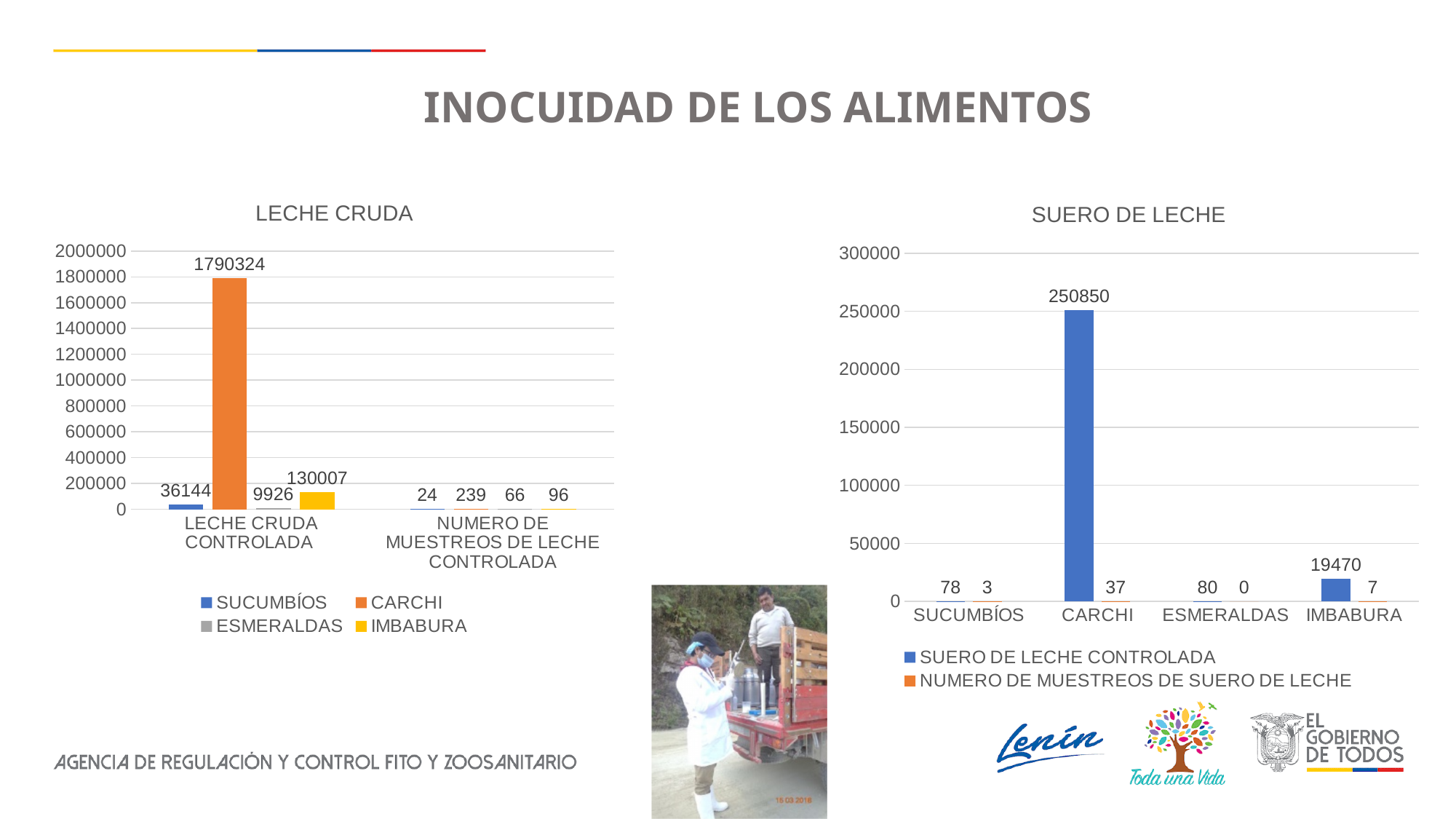
In the SUERO DE LECHE chart, what is the value of NUMERO DE MUESTREOS DE SUERO DE LECHE for ESMERALDAS? 0 In the LECHE CRUDA chart, is the value for CARCHI under LECHE CRUDA CONTROLADA greater or less than 1600000? greater In the SUERO DE LECHE chart, how many provinces are shown on the x axis? 4 In the LECHE CRUDA chart, what is the value for IMBABURA under NUMERO DE MUESTREOS DE LECHE CONTROLADA? 96 In the LECHE CRUDA chart, which province has the lowest value for LECHE CRUDA CONTROLADA? ESMERALDAS In the SUERO DE LECHE chart, what is the difference between CARCHI and IMBABURA for SUERO DE LECHE CONTROLADA? 231380 In the LECHE CRUDA chart, what is the value for CARCHI under LECHE CRUDA CONTROLADA? 1790324 In the LECHE CRUDA chart, how many series does the legend list? 4 What type of chart is the SUERO DE LECHE chart? Bar chart In the LECHE CRUDA chart, what is the difference between IMBABURA and SUCUMBÍOS for LECHE CRUDA CONTROLADA? 93863 In the SUERO DE LECHE chart, what is the value of SUERO DE LECHE CONTROLADA for IMBABURA? 19470 In the SUERO DE LECHE chart, which province has the highest value for SUERO DE LECHE CONTROLADA? CARCHI